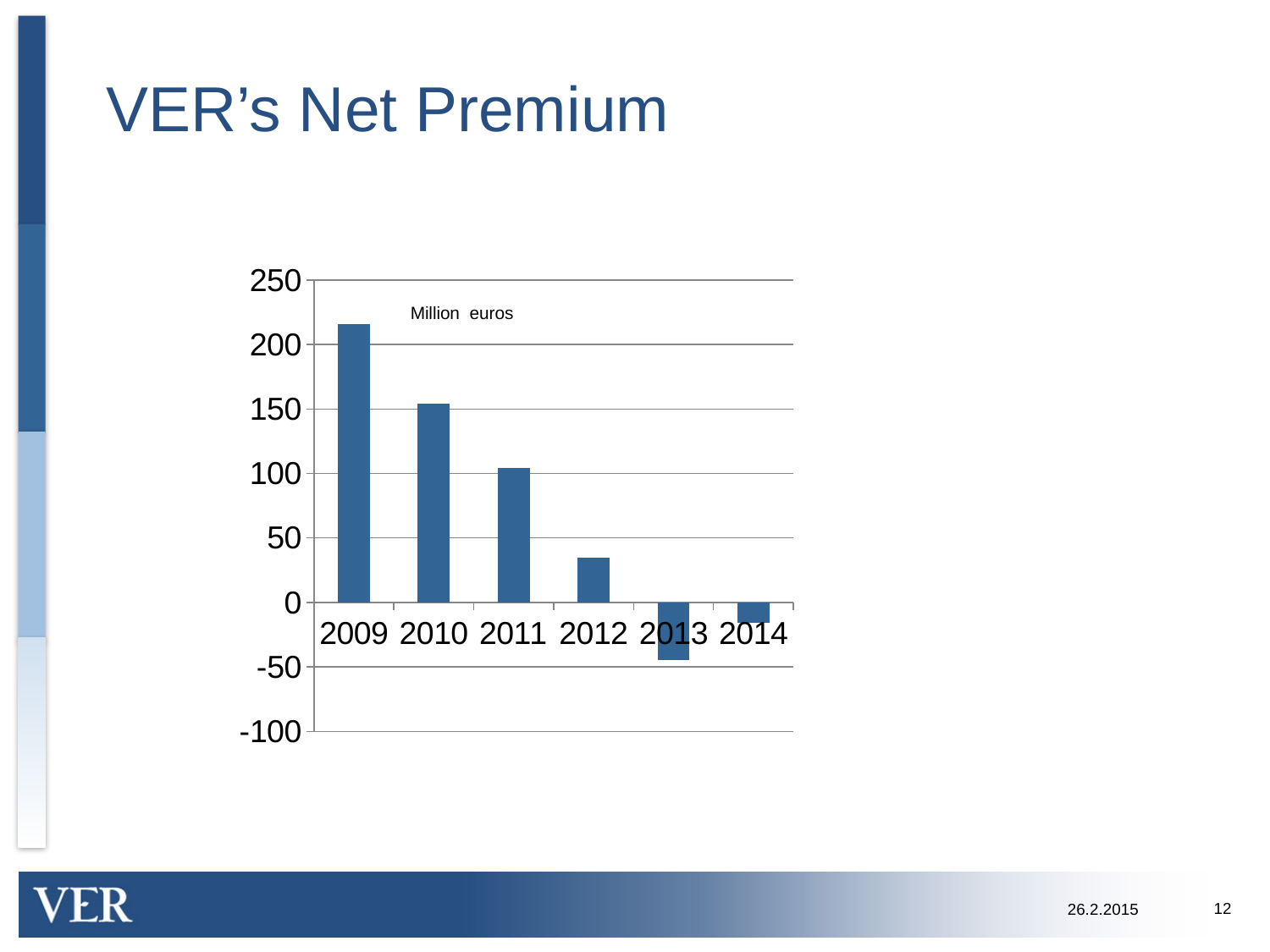
How many years are shown on the x axis of the chart? 6 Is the value for 2013 greater or less than 0? less What kind of chart is shown on the slide? bar chart Is the value for 2011 greater or less than 150? less Which year has the lowest net premium in the chart? 2013 Which year has the larger net premium, 2010 or 2012? 2010 Do the values rise or fall from 2009 to 2013? fall Is the value for 2009 greater or less than 200? greater What unit is stated inside the chart area? Million euros Which year has the highest net premium in the chart? 2009